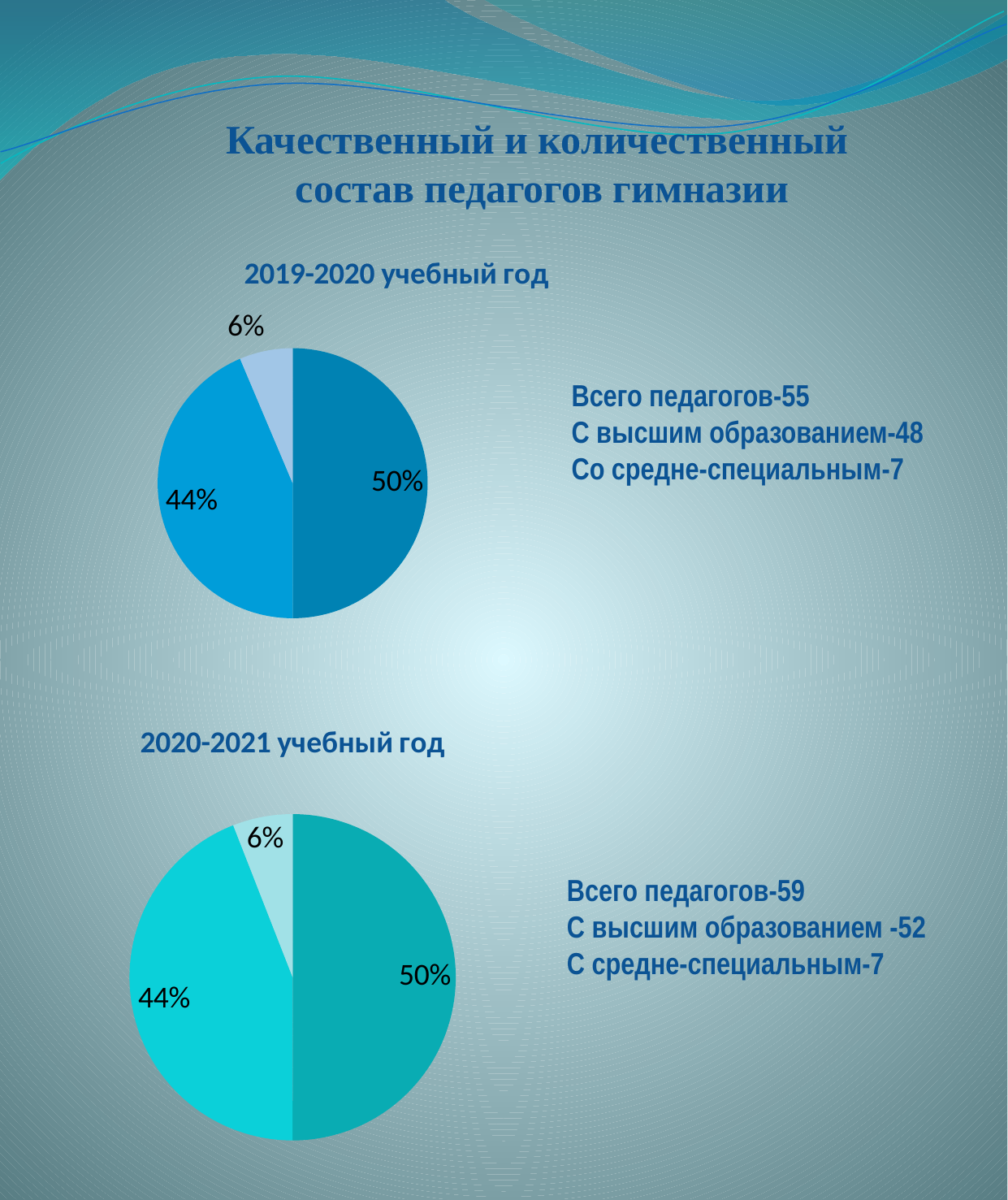
What kind of chart is shown under the heading "2019-2020 учебный год"? pie chart In the "2020-2021 учебный год" pie chart, what is the share of the largest slice? 50% In the "2019-2020 учебный год" pie chart, what is the share of the smallest slice? 6% What kind of chart is shown under the heading "2020-2021 учебный год"? pie chart In the "2019-2020 учебный год" pie chart, what is the difference between the largest and the smallest slice? 44% In the "2019-2020 учебный год" pie chart, which is larger: the slice labelled 44% or the slice labelled 6%? the 44% slice What is the title of the lower pie chart on the slide? 2020-2021 учебный год In the "2019-2020 учебный год" pie chart, how many slices are there? 3 In the "2020-2021 учебный год" pie chart, how many slices are there? 3 In the "2020-2021 учебный год" pie chart, what is the share of the smallest slice? 6% In the "2020-2021 учебный год" pie chart, what is the difference between the 50% slice and the 44% slice? 6% In the "2019-2020 учебный год" pie chart, what is the share of the largest slice? 50%